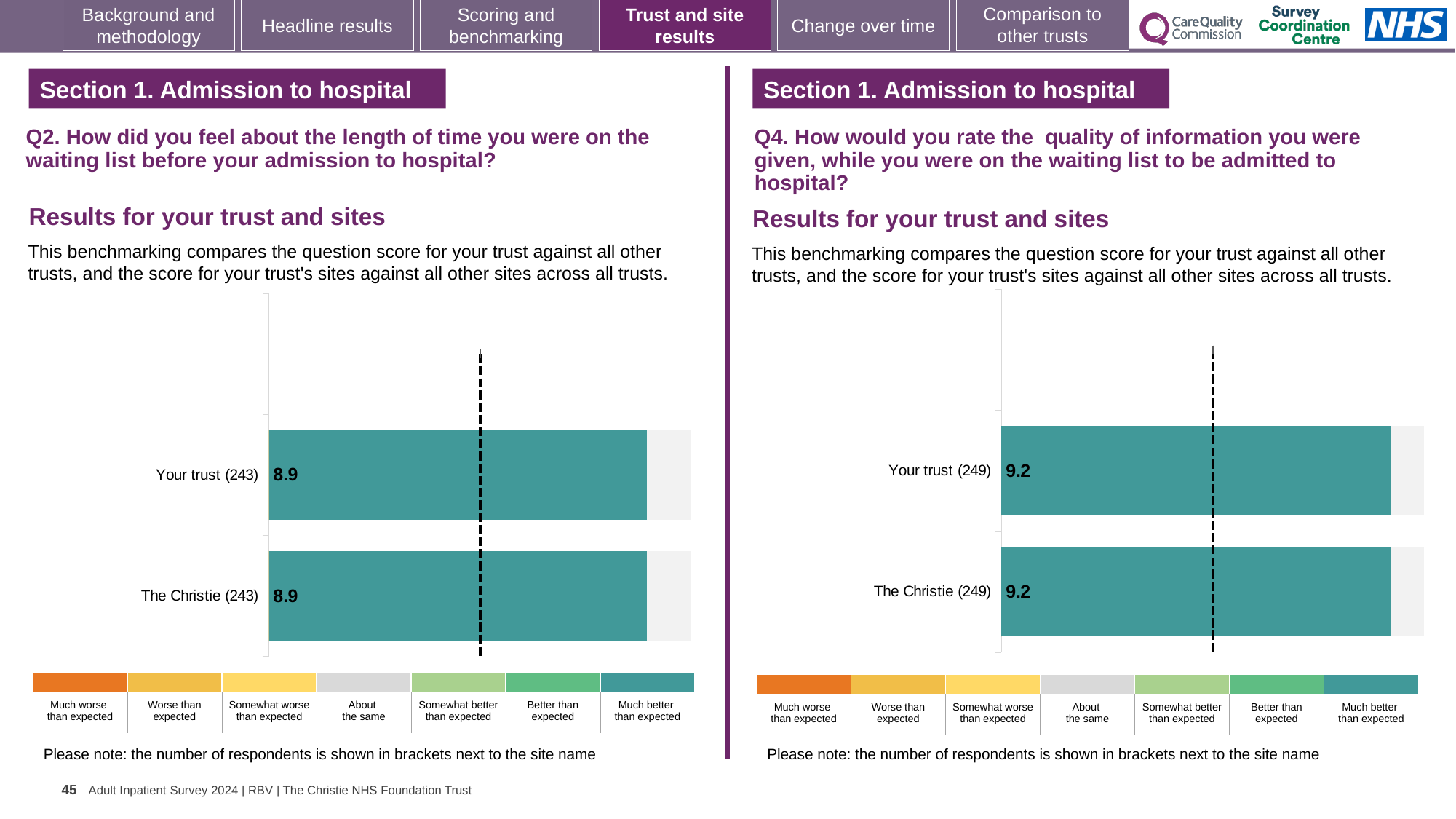
What kind of chart is the Q2 chart (left)? Bar chart On the Q4 chart (right), what is the difference between the scores for Your trust and The Christie? 0 How many bars are plotted on the Q4 chart (right)? 2 On the Q2 chart (left), what is the score for The Christie? 8.9 Is the score for Your trust on the Q4 chart (right) larger or smaller than the score for Your trust on the Q2 chart (left)? Larger How many bars are plotted on the Q2 chart (left)? 2 On the Q2 chart (left), how many respondents are shown in brackets next to Your trust? 243 On the Q4 chart (right), what is the score for The Christie? 9.2 On the Q2 chart (left), what is the difference between the scores for Your trust and The Christie? 0 On the Q4 chart (right), how many respondents are shown in brackets next to The Christie? 249 On the Q4 chart (right), what is the score for Your trust? 9.2 On the Q2 chart (left), what is the score for Your trust? 8.9